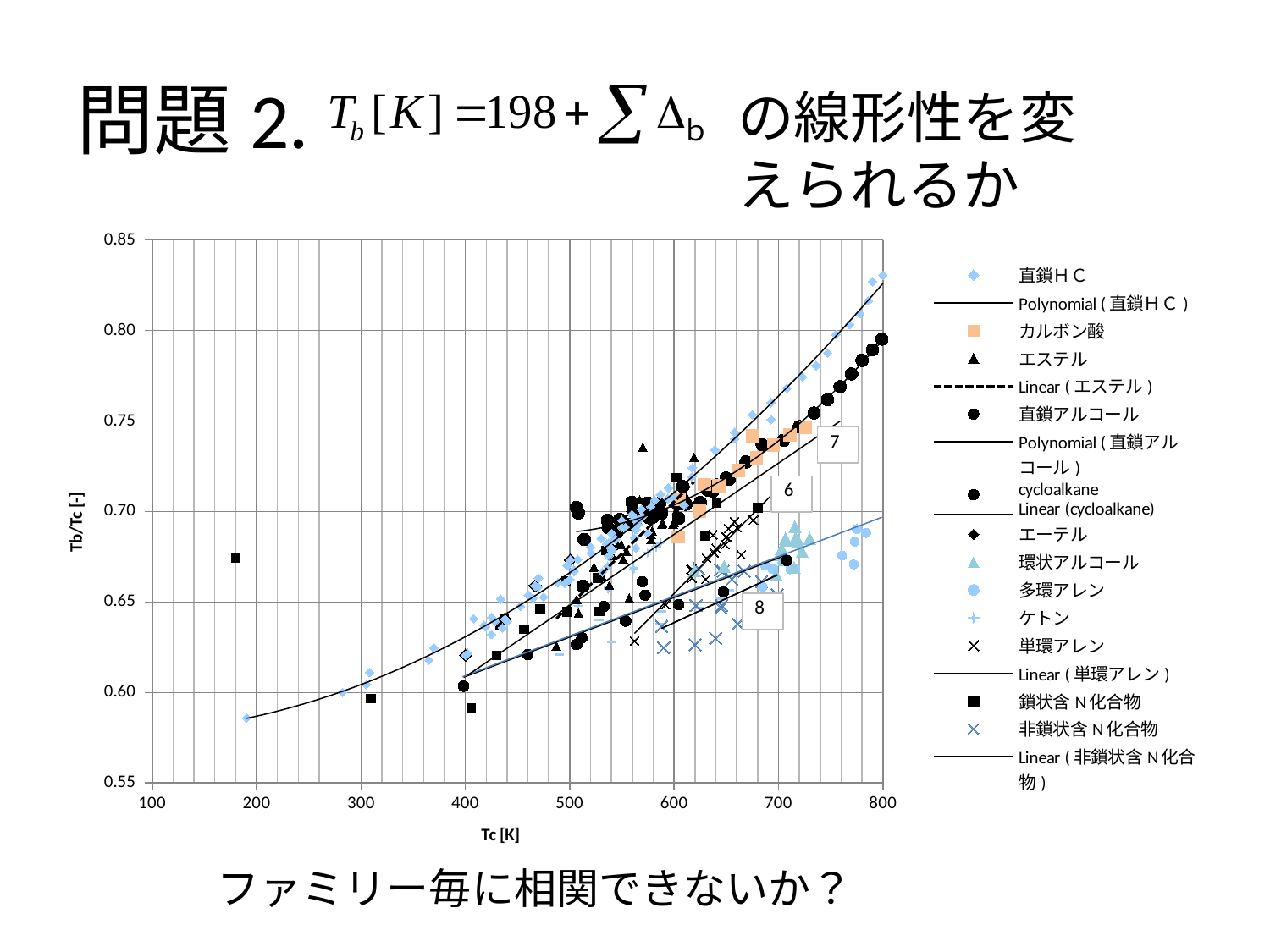
Is the Tb/Tc value of the leftmost 直鎖ＨＣ point (near Tc = 190 K) greater or less than 0.60? less At Tc = 800 K, which is larger: the Tb/Tc value of the 直鎖ＨＣ point or the 直鎖アルコール point? 直鎖ＨＣ What is the maximum value shown on the y axis of the chart? 0.85 Is the Tb/Tc value of the 鎖状含N化合物 point near Tc = 180 K greater or less than 0.65? greater Is the Tb/Tc value of the 直鎖ＨＣ point at Tc = 800 K greater or less than 0.80? greater Which series reaches the highest Tb/Tc value on the chart? 直鎖ＨＣ What is the title of the x axis of the chart? Tc [K] How many entries does the chart's legend list? 18 What kind of chart is shown on the slide? scatter chart What is the title of the y axis of the chart? Tb/Tc [-] Do the Tb/Tc values for the 直鎖ＨＣ series rise or fall as Tc increases? rise